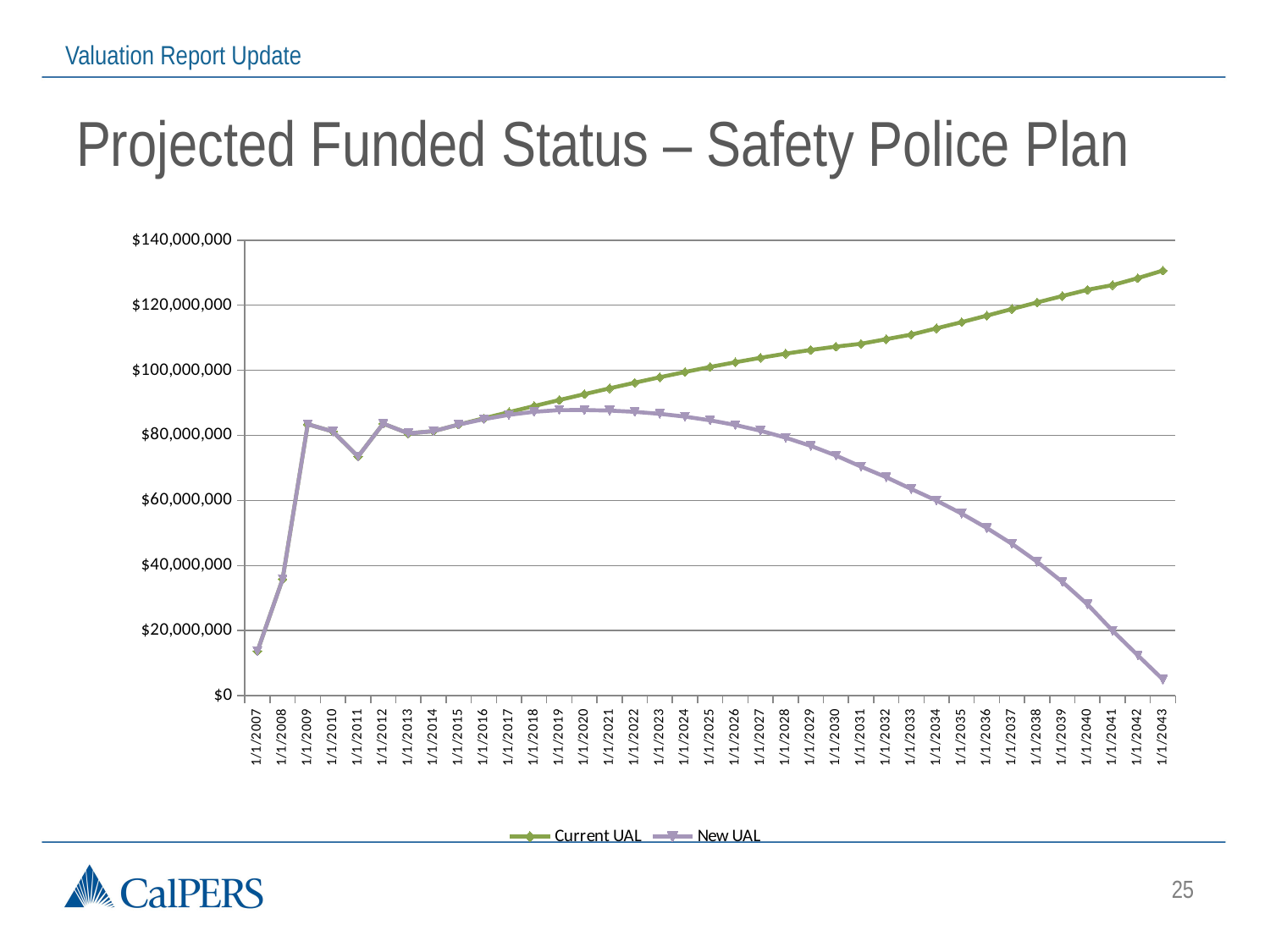
How many dates are shown along the x axis? 37 Is the Current UAL value at 1/1/2020 greater or less than $100,000,000? less How many series does the legend list? 2 At 1/1/2043, which series has the larger value, Current UAL or New UAL? Current UAL At which date does the Current UAL series reach its highest value? 1/1/2043 What are the two series named in the legend? Current UAL and New UAL Does the Current UAL series rise or fall from 1/1/2017 to 1/1/2043? Rise Is the New UAL value at 1/1/2043 greater or less than $20,000,000? less Is the New UAL value at 1/1/2008 greater or less than $40,000,000? less What is the title of the chart on the slide? Projected Funded Status – Safety Police Plan What kind of chart is shown on the slide? Line chart